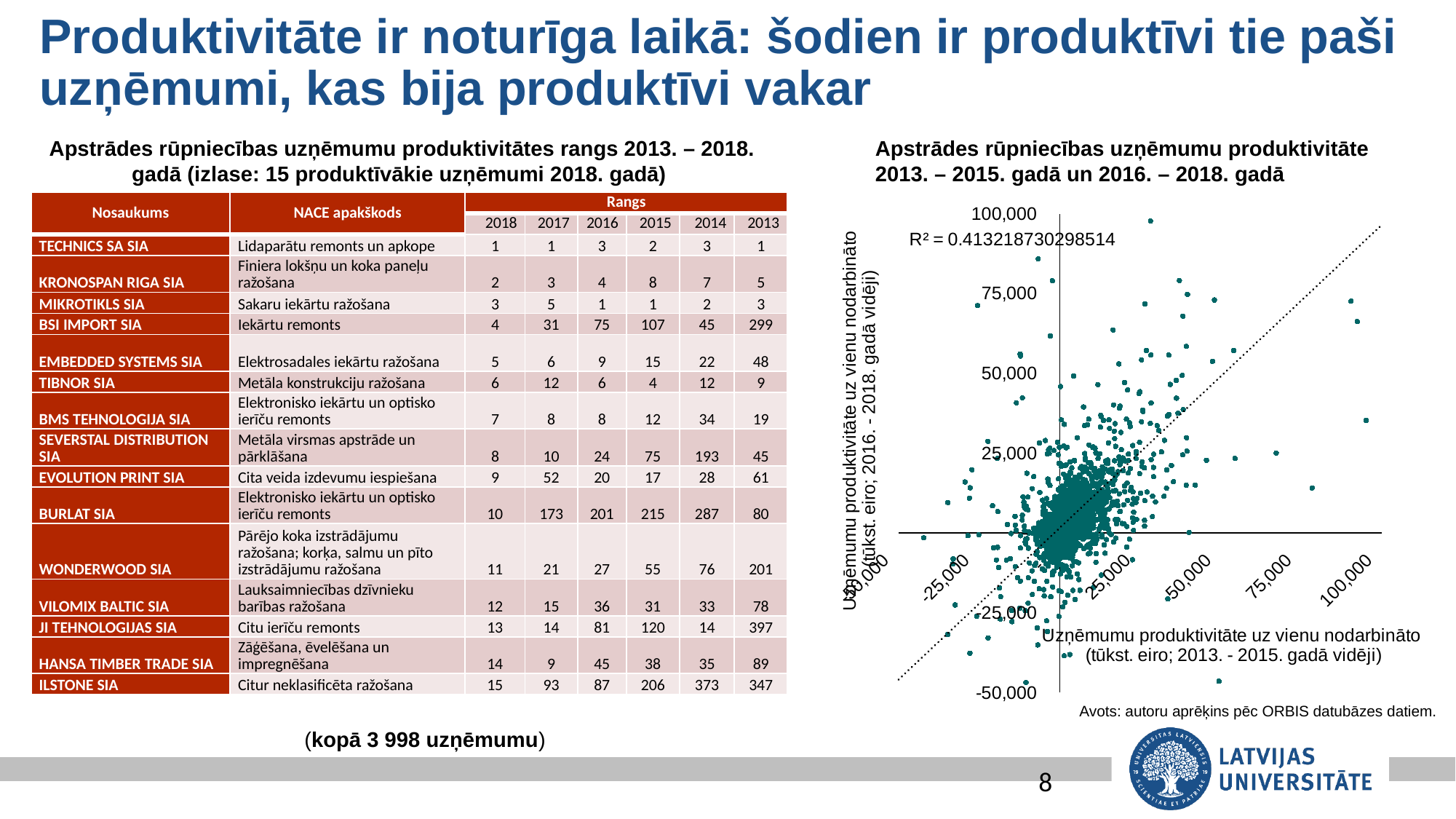
What R² value is printed on the scatter chart? R² = 0.413218730298514 What is the highest tick value shown on the y axis of the scatter chart? 100,000 What is the highest tick value shown on the x axis of the scatter chart? 100,000 What is the title of the scatter chart on the right of the slide? Apstrādes rūpniecības uzņēmumu produktivitāte 2013. – 2015. gadā un 2016. – 2018. gadā What is the lowest tick value shown on the y axis of the scatter chart? -50,000 What kind of chart is shown on the right side of the slide? scatter chart In the scatter chart, do the points generally rise or fall as the x-axis value increases? rise Which period does the x axis of the scatter chart refer to, according to its axis label? 2013. - 2015. gadā vidēji